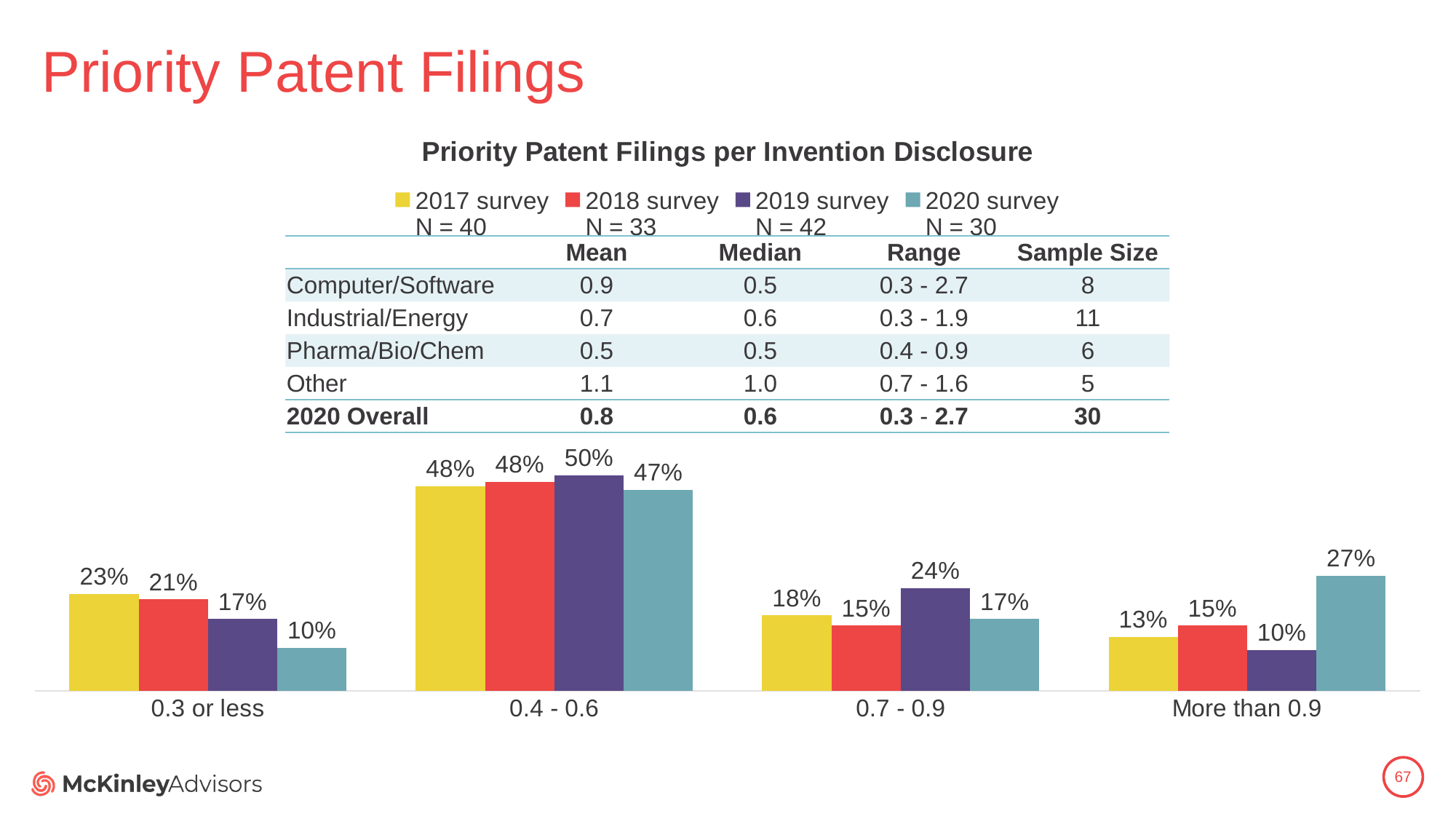
What is the difference between the 2020 survey and the 2019 survey values in the 'More than 0.9' category? 17% What kind of chart is shown on the slide? Bar chart Which is larger in the '0.3 or less' category: the 2017 survey or the 2018 survey? 2017 survey What is the value for the 2019 survey in the '0.7 - 0.9' category? 24% What is the title of the chart? Priority Patent Filings per Invention Disclosure Which category has the highest value for the 2020 survey? 0.4 - 0.6 What is the sample size (N) for the 2019 survey shown in the legend? 42 How many series does the chart legend list? 4 Which category has the lowest value for the 2019 survey? More than 0.9 What is the value for the 2020 survey in the '0.3 or less' category? 10% What is the value for the 2017 survey in the 'More than 0.9' category? 13% How many categories are shown on the x axis of the chart? 4